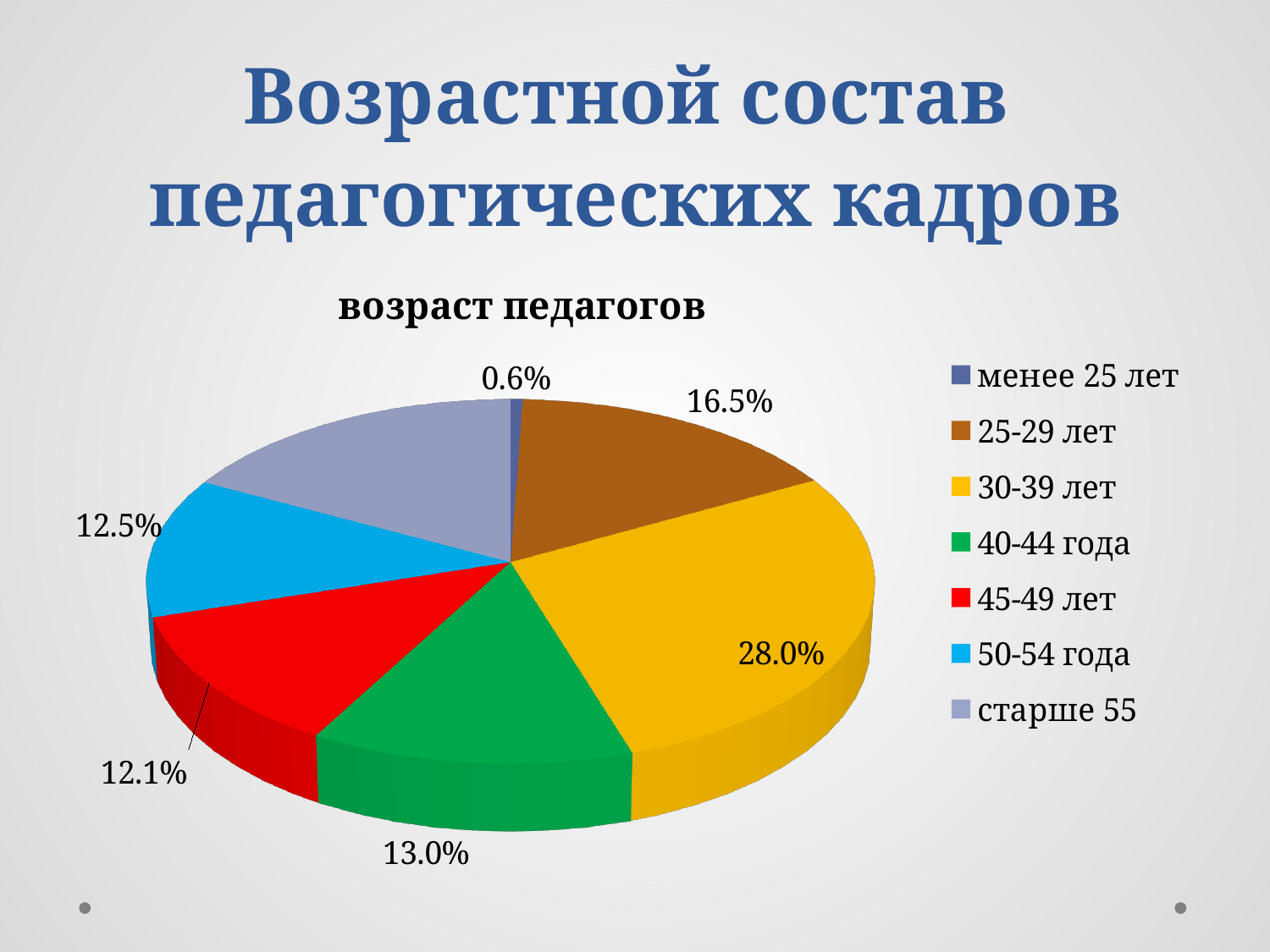
What is the difference between the shares of 30-39 лет and 25-29 лет? 11.5% What share of the pie is labelled for the 30-39 лет category? 28.0% What is the title of the chart? возраст педагогов Which colour represents the 45-49 лет category in the chart? red Which category has the largest share of the pie? 30-39 лет What share of the pie is labelled for the менее 25 лет category? 0.6% How many categories does the legend of the chart list? 7 What share of the pie is labelled for the 40-44 года category? 13.0% Which category has the smallest share of the pie? менее 25 лет What share of the pie is labelled for the 25-29 лет category? 16.5% What share of the pie is labelled for the 50-54 года category? 12.5% What kind of chart is shown on the slide? pie chart